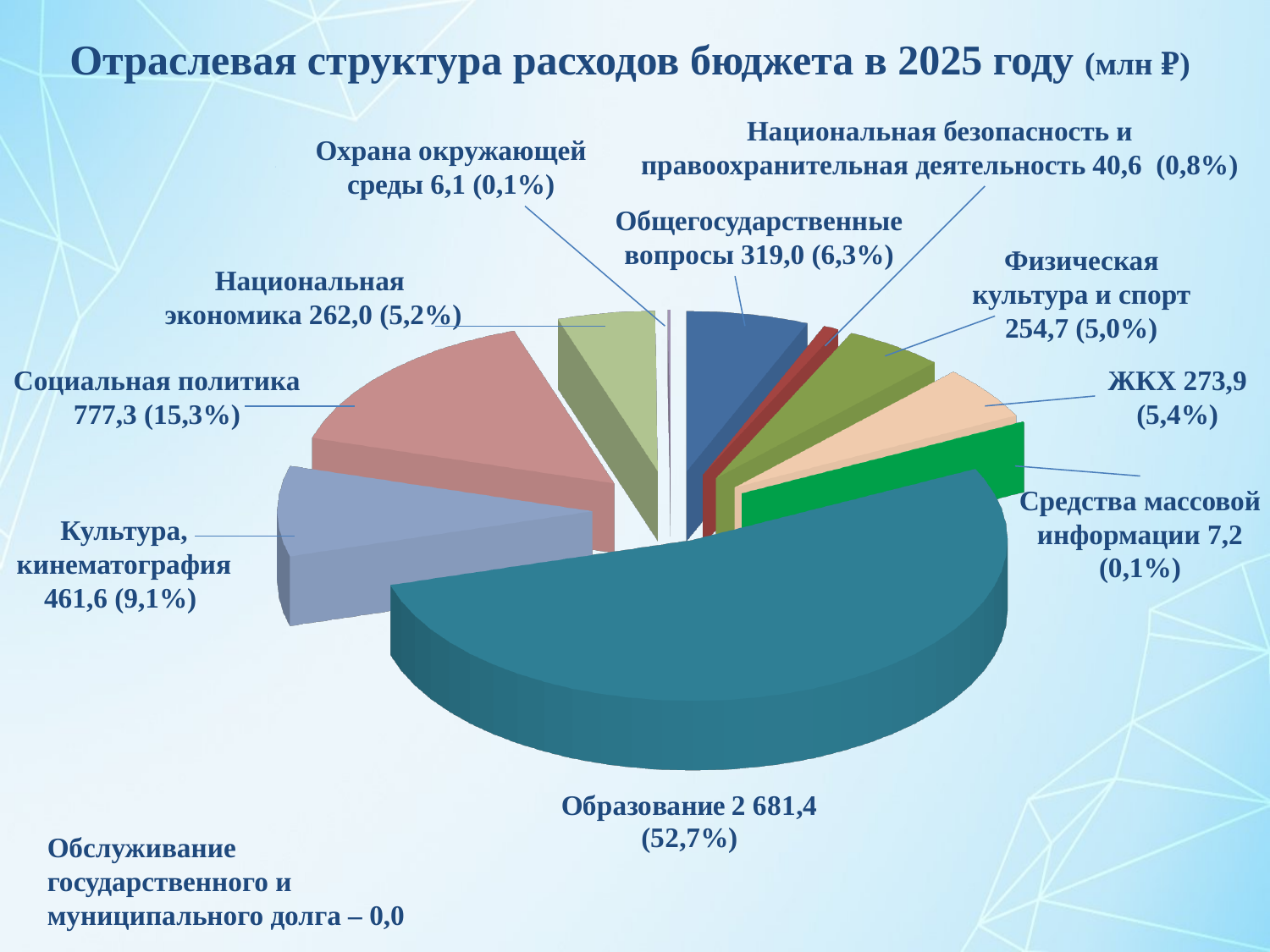
What is the value for Национальная безопасность и правоохранительная деятельность? 40,6 Which is larger, the value for ЖКХ or the value for Физическая культура и спорт? ЖКХ What is the value for ЖКХ? 273,9 What is the difference between the values for Социальная политика and Культура, кинематография? 315,7 What share of the pie does Культура, кинематография represent? 9,1% What is the value for Социальная политика? 777,3 What is the title of the chart? Отраслевая структура расходов бюджета в 2025 году (млн ₽) What kind of chart is shown on the slide? pie chart What is the value for Образование? 2 681,4 What share of the pie does Общегосударственные вопросы represent? 6,3% Which category has the smallest value among the pie slices? Охрана окружающей среды Which category has the largest share of the pie? Образование